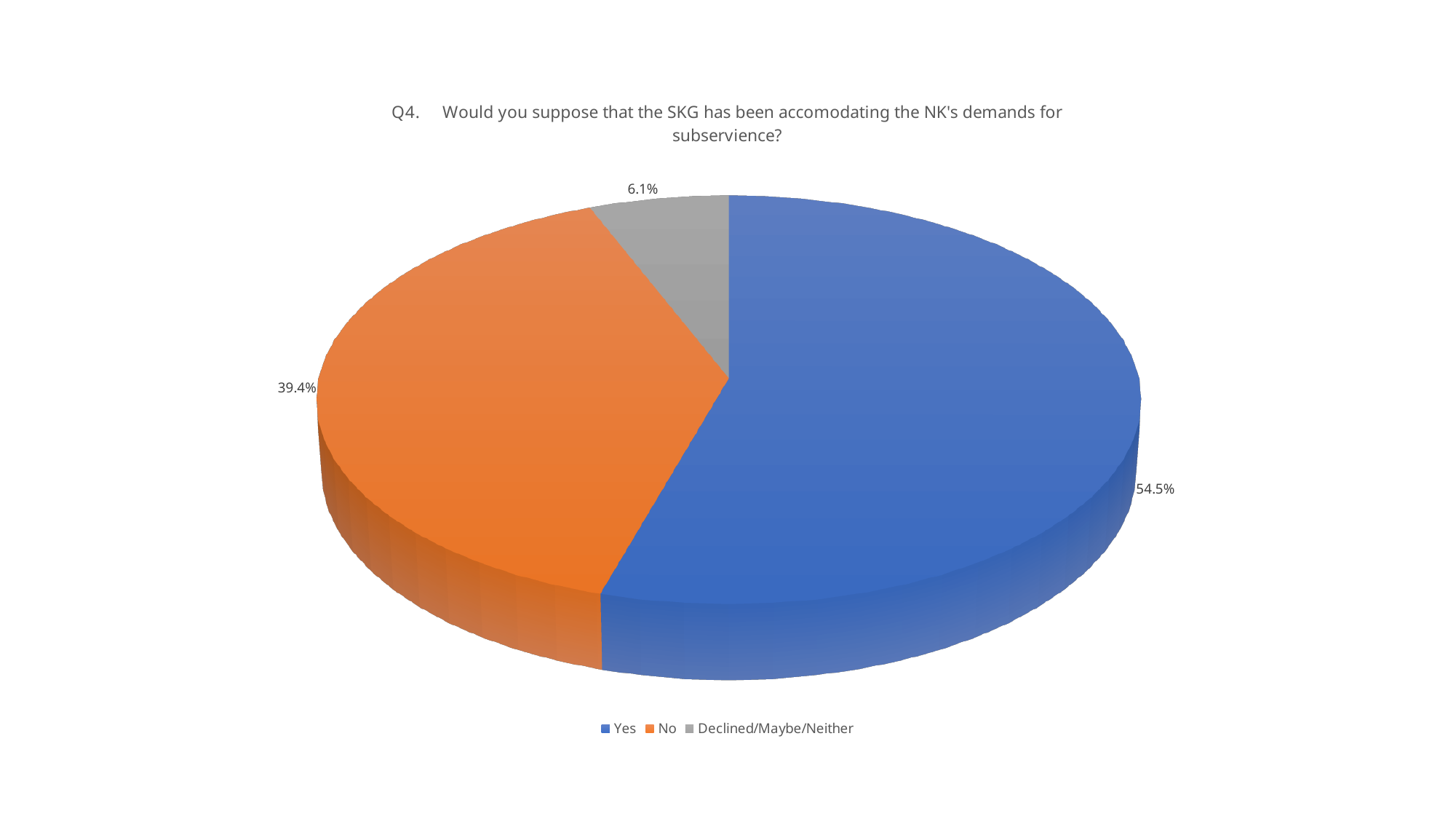
Which is larger, the share for No or the share for Declined/Maybe/Neither? No What kind of chart is shown on the slide? Pie chart What percentage of respondents answered No? 39.4% How many slices does the pie chart have? 3 What percentage of respondents fall under Declined/Maybe/Neither? 6.1% What percentage of respondents answered Yes? 54.5% Which response has the largest share of the pie? Yes Which response has the smallest share of the pie? Declined/Maybe/Neither What question number is shown in the chart title? Q4 What is the difference in percentage points between the Yes and No shares? 15.1 What colour is the slice representing No? Orange How many entries does the legend list? 3